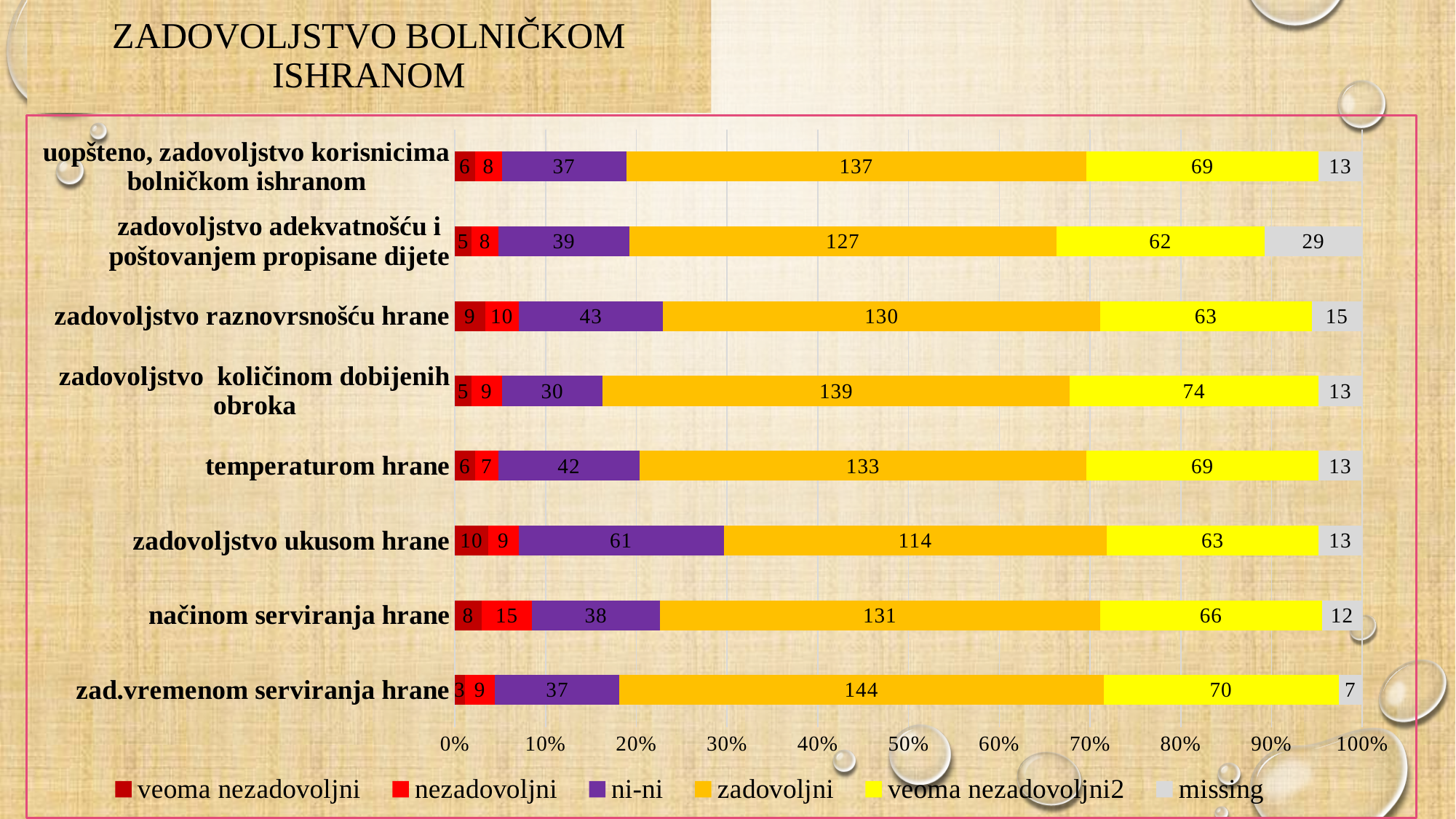
Which category has the highest 'missing' value? zadovoljstvo adekvatnošću i poštovanjem propisane dijete What is the value of the 'zadovoljni' series for 'temperaturom hrane'? 133 Which category has the lowest 'zadovoljni' value? zadovoljstvo ukusom hrane What is the 'ni-ni' value for 'zadovoljstvo ukusom hrane'? 61 How many series does the legend list? 6 What is the total of all segments in the bar for 'zad.vremenom serviranja hrane'? 270 What is the difference between the 'zadovoljni' values for 'zad.vremenom serviranja hrane' and 'zadovoljstvo ukusom hrane'? 30 How many categories are shown on the chart? 8 What kind of chart is shown on the slide? Stacked bar chart Which has the larger 'veoma nezadovoljni2' value: 'zadovoljstvo količinom dobijenih obroka' or 'zadovoljstvo ukusom hrane'? zadovoljstvo količinom dobijenih obroka Which category has the highest 'zadovoljni' value? zad.vremenom serviranja hrane What is the 'missing' value for 'zadovoljstvo adekvatnošću i poštovanjem propisane dijete'? 29